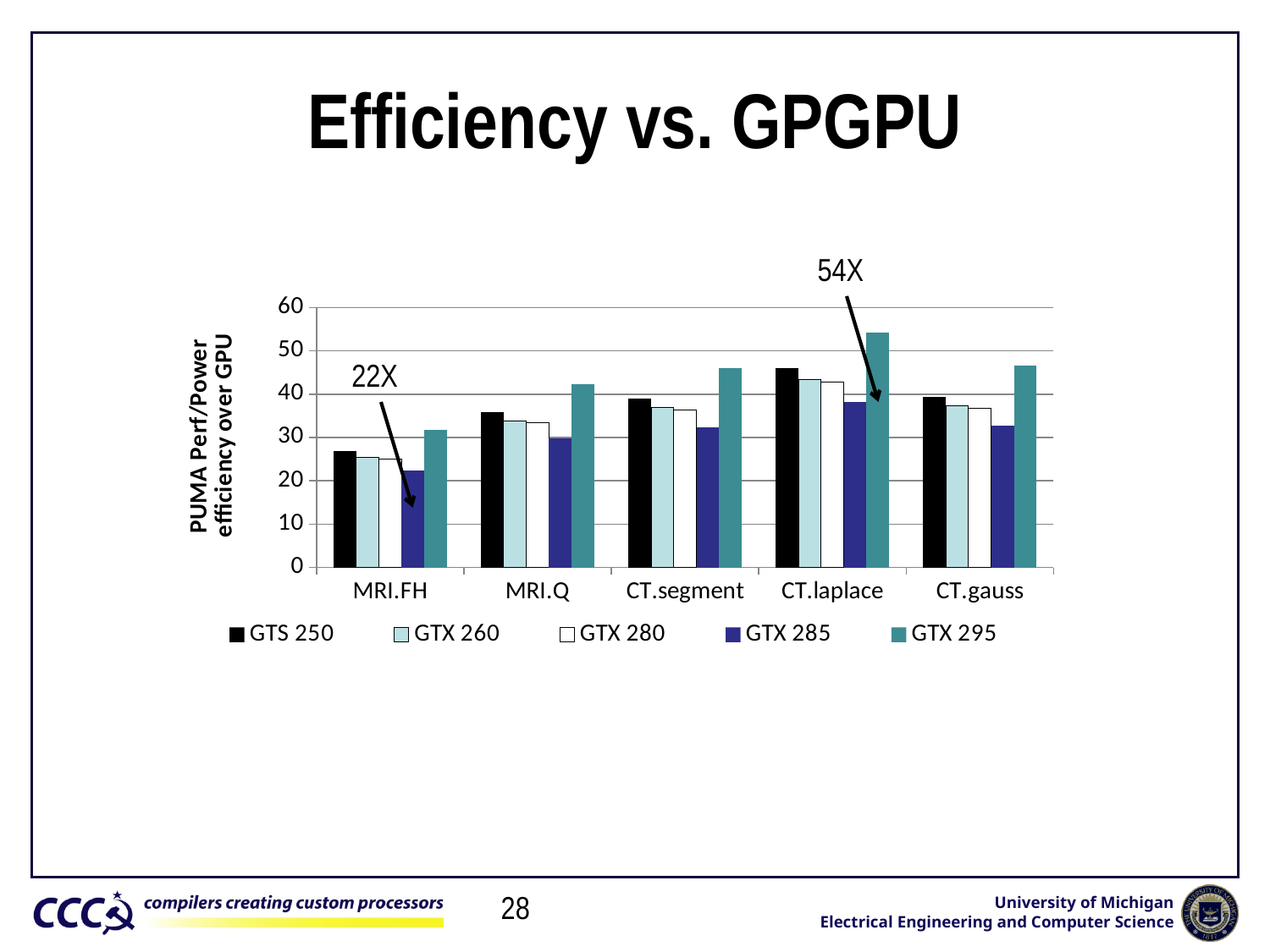
Is the GTX 295 value for CT.segment greater or less than 40? greater Which benchmark has the lowest GTX 285 bar? MRI.FH What kind of chart is shown on the slide? bar chart Is the GTS 250 value for MRI.FH greater or less than 30? less Which is larger: the GTS 250 value for CT.laplace or the GTS 250 value for CT.gauss? CT.laplace What value is annotated for the GTX 285 bar in the MRI.FH group? 22X Within the CT.laplace group, which series has the lowest bar? GTX 285 Which benchmark has the highest GTX 295 bar? CT.laplace How many benchmark categories are shown on the x axis? 5 What is the label on the y axis of the chart? PUMA Perf/Power efficiency over GPU How many series does the legend list? 5 What value is annotated for the GTX 295 bar in the CT.laplace group? 54X